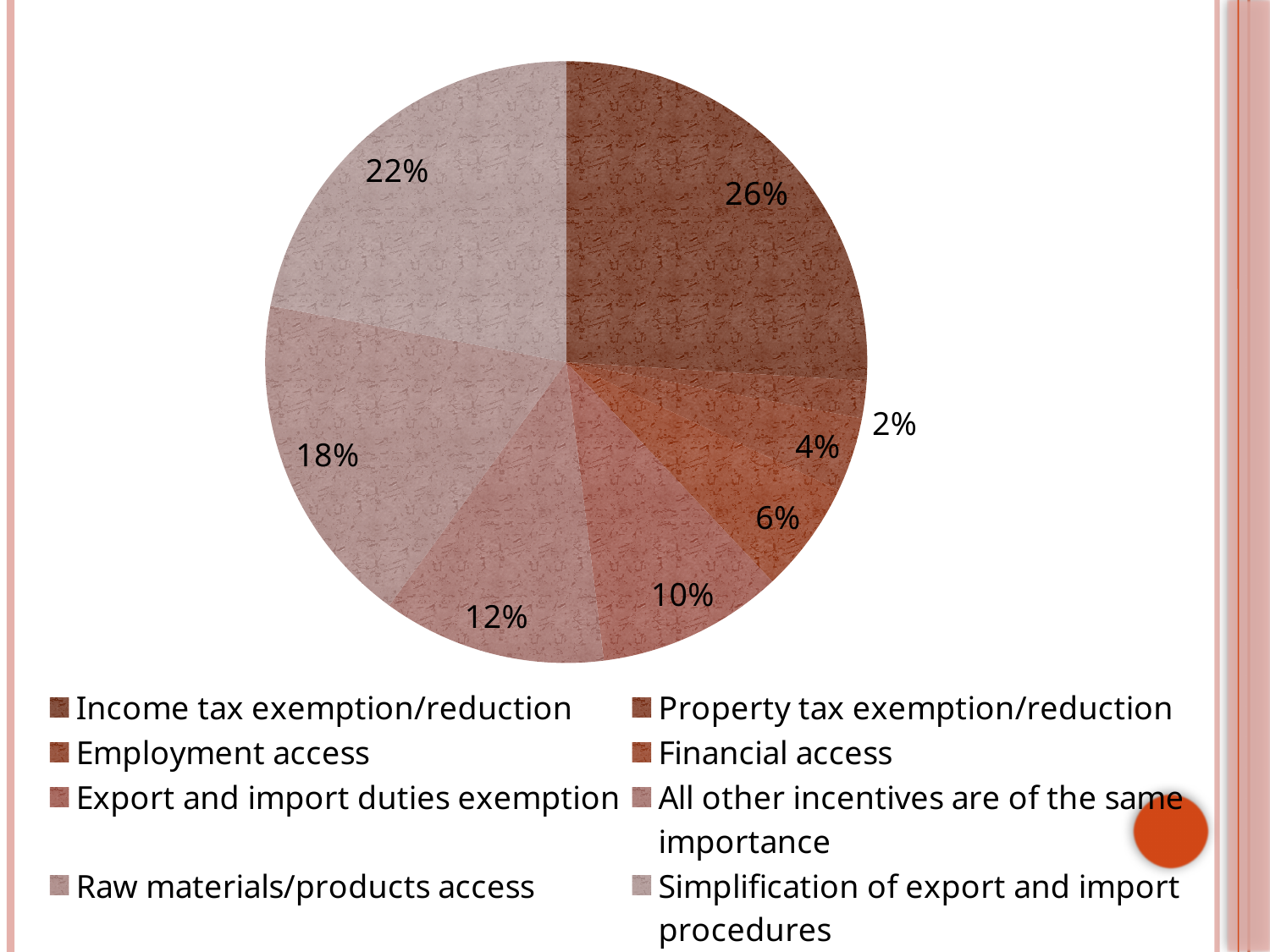
What kind of chart is shown on the slide? pie chart Which is larger, the share for Financial access or the share for Employment access? Financial access Which category has the largest slice of the pie? Income tax exemption/reduction What share of the pie does Raw materials/products access represent? 18% How many slices does the pie chart have? 8 What share of the pie does Income tax exemption/reduction represent? 26% What share of the pie does Simplification of export and import procedures represent? 22% What is the value shown for Property tax exemption/reduction? 2% Which category has the smallest slice of the pie? Property tax exemption/reduction What is the value shown for Export and import duties exemption? 10% How many entries does the legend list? 8 What is the difference between the shares for Income tax exemption/reduction and Simplification of export and import procedures? 4%